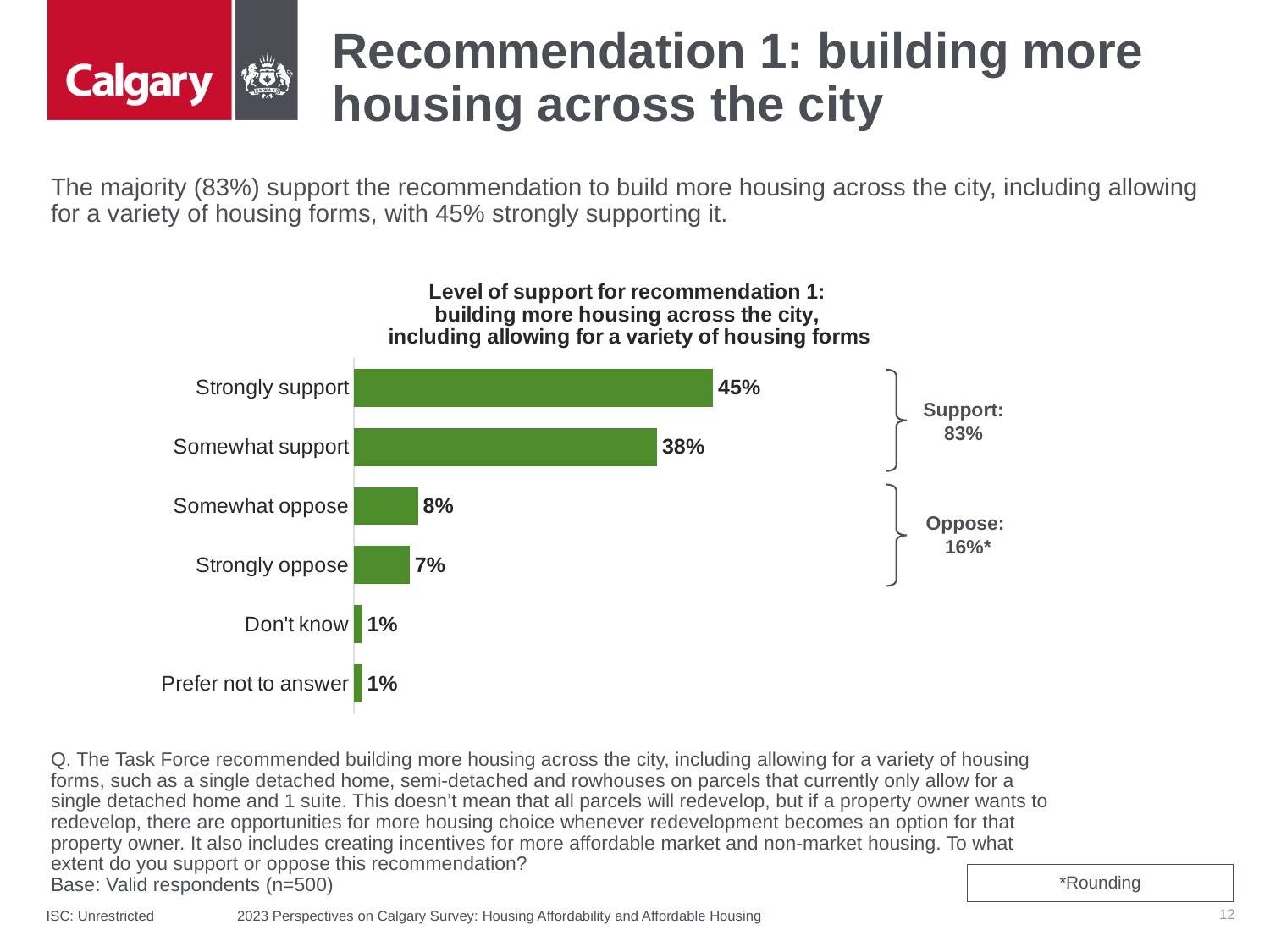
What percentage of respondents somewhat oppose recommendation 1? 8% Which is larger, the percentage for 'Somewhat oppose' or 'Strongly oppose'? Somewhat oppose What is the combined percentage for 'Don't know' and 'Prefer not to answer'? 2% What kind of chart is shown on the slide? Bar chart What total oppose percentage is shown beside the bracket grouping the oppose categories? 16%* How many response categories are shown in the chart? 6 Which response category has the highest percentage? Strongly support What is the difference in percentage points between 'Strongly support' and 'Somewhat support'? 7 What percentage of respondents strongly oppose recommendation 1? 7% What total support percentage is shown beside the bracket grouping the support categories? 83% What percentage of respondents somewhat support recommendation 1? 38% What percentage of respondents strongly support recommendation 1? 45%